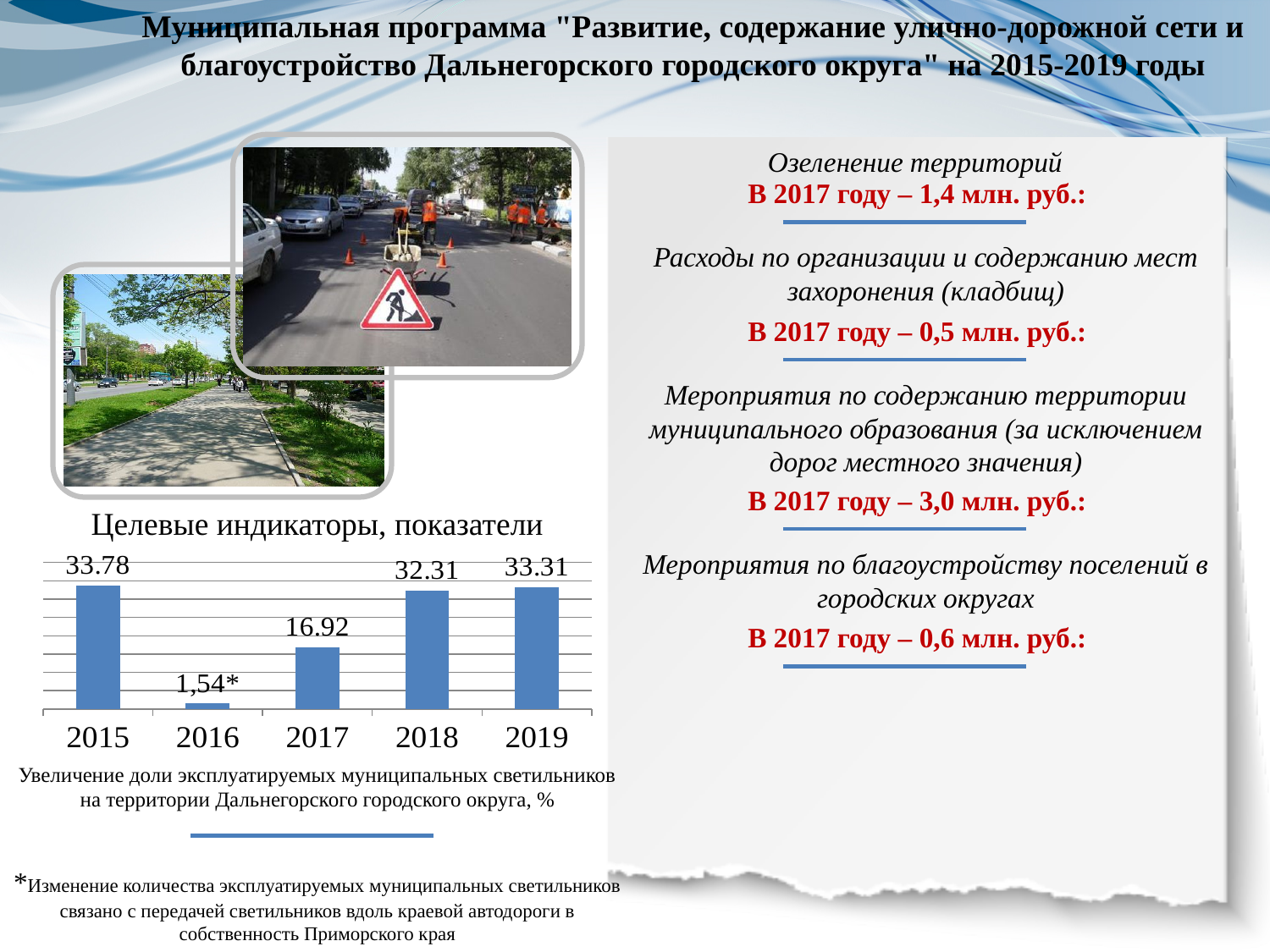
Which year has the highest value in the chart? 2015 What is the difference between the values for 2018 and 2017? 15.39 Which is larger, the value for 2017 or the value for 2018? 2018 How many years are shown on the x axis of the chart? 5 What is the value for 2019 in the chart? 33.31 What is the value shown for 2016 in the chart? 1,54* What is the value for 2018 in the chart? 32.31 What type of chart is shown on the slide? bar chart What is the value for 2015 in the chart "Целевые индикаторы, показатели"? 33.78 Which year has the lowest value in the chart? 2016 What is the value for 2017 in the chart? 16.92 What is the title of the chart on the slide? Целевые индикаторы, показатели